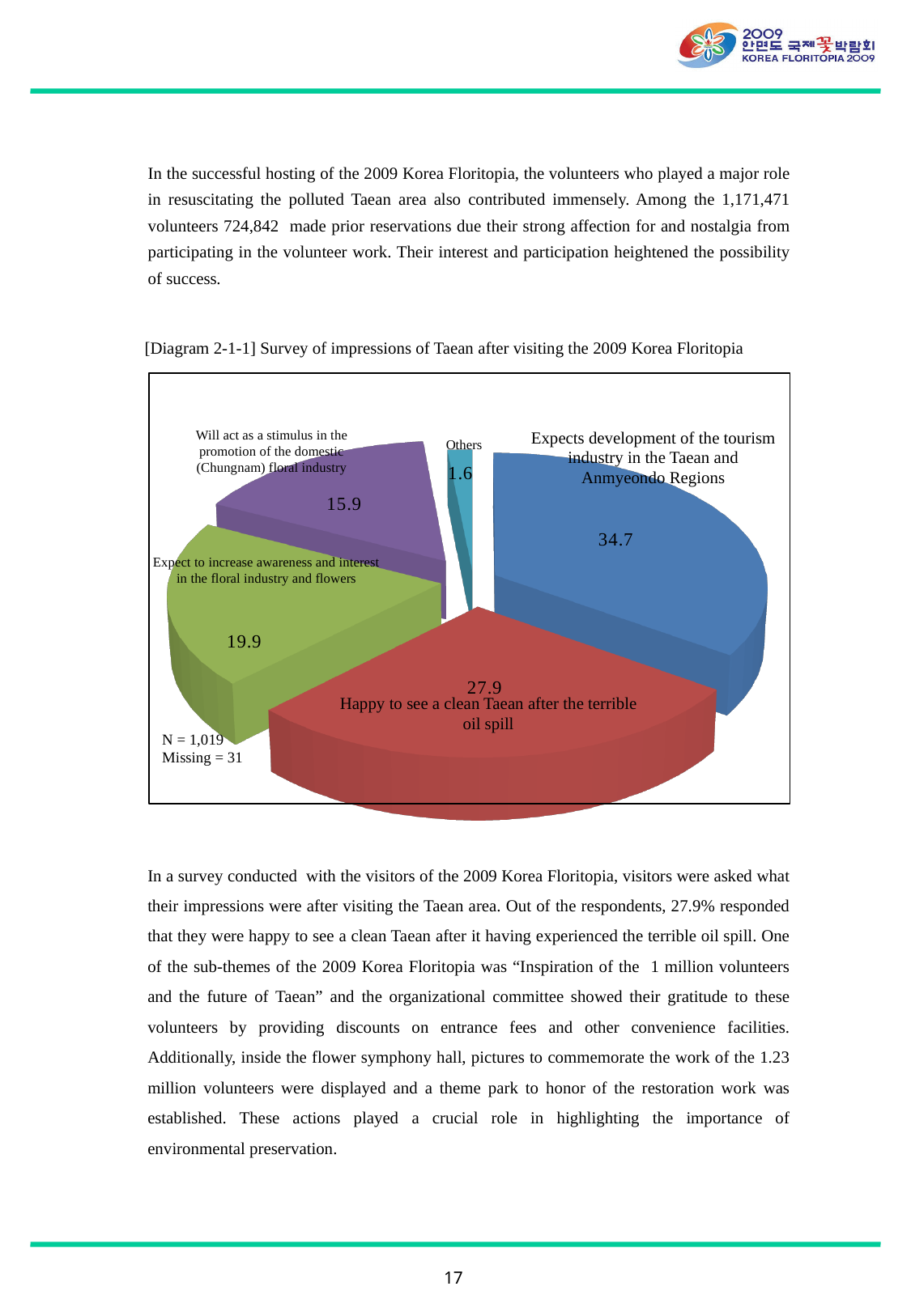
What is the value for 'Expect to increase awareness and interest in the floral industry and flowers'? 19.9 What is the value for 'Happy to see a clean Taean after the terrible oil spill'? 27.9 What is the value for 'Others'? 1.6 What is the value for 'Will act as a stimulus in the promotion of the domestic (Chungnam) floral industry'? 15.9 Which is larger: the value for 'Expect to increase awareness and interest in the floral industry and flowers' or 'Will act as a stimulus in the promotion of the domestic (Chungnam) floral industry'? Expect to increase awareness and interest in the floral industry and flowers Which category has the largest slice of the pie? Expects development of the tourism industry in the Taean and Anmyeondo Regions What is the difference between the values for 'Expects development of the tourism industry' and 'Happy to see a clean Taean after the terrible oil spill'? 6.8 What is the value of N shown on the chart? 1,019 How many slices does the pie chart have? 5 What kind of chart is shown in Diagram 2-1-1? Pie chart Which category has the smallest slice of the pie? Others What is the value for 'Expects development of the tourism industry in the Taean and Anmyeondo Regions'? 34.7